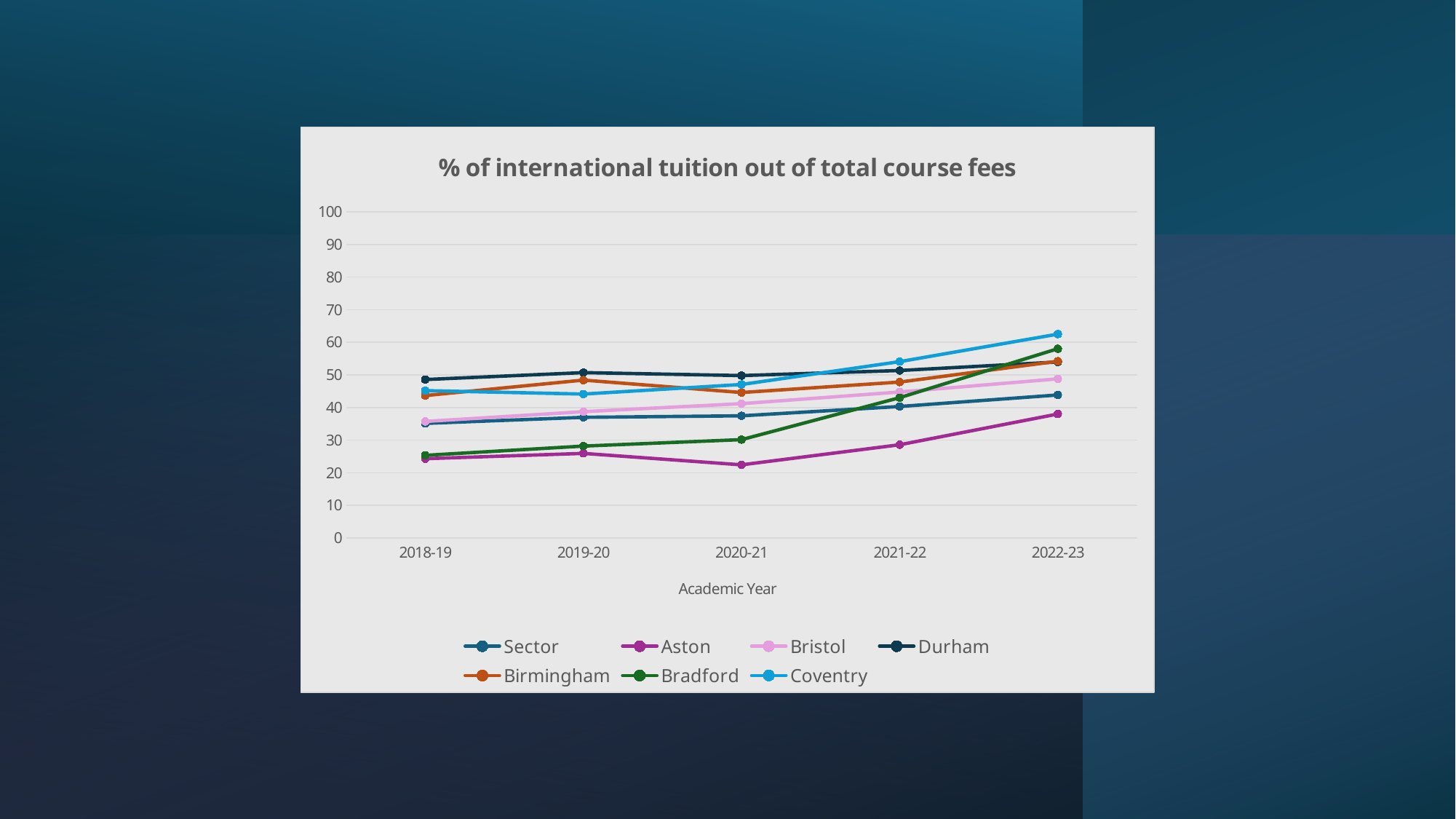
Which series has the lowest value in 2020-21? Aston Is the value for Coventry in 2022-23 greater or less than 60? greater Which series has the lowest value in 2022-23? Aston What kind of chart is shown on the slide? line chart Which series has the highest value in 2018-19? Durham How many series does the legend list? 7 How many academic years are plotted along the x axis? 5 Which series has the highest value in 2022-23? Coventry Is the value for Aston in 2020-21 greater or less than 30? less Is the value for Bradford in 2022-23 greater or less than 50? greater Does the Bradford line rise or fall from 2020-21 to 2022-23? rise In 2021-22, which is larger: Bradford or Aston? Bradford